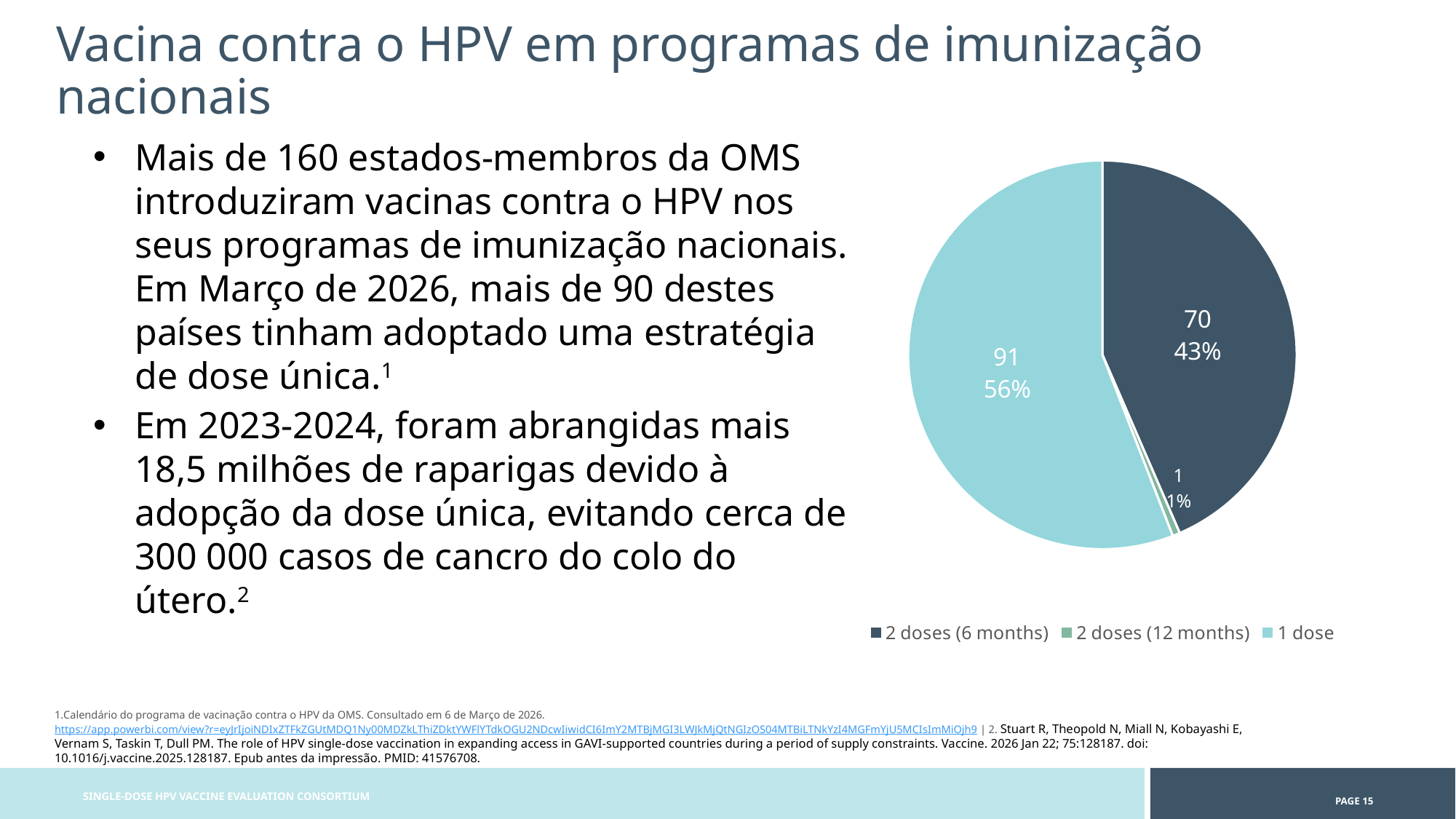
Which category has the largest slice in the pie chart? 1 dose What is the value shown for the "2 doses (12 months)" slice of the pie chart? 1 What kind of chart is shown on the slide? pie chart What is the value shown for the "2 doses (6 months)" slice of the pie chart? 70 How many entries does the pie chart's legend list? 3 How many slices does the pie chart have? 3 What is the value shown for the "1 dose" slice of the pie chart? 91 Which category has the smallest slice in the pie chart? 2 doses (12 months) Which legend entry is shown in the dark blue colour in the pie chart? 2 doses (6 months) What is the difference between the values for "1 dose" and "2 doses (6 months)" in the pie chart? 21 What percentage share of the pie does the "1 dose" slice represent? 56% What percentage share of the pie does the "2 doses (6 months)" slice represent? 43%